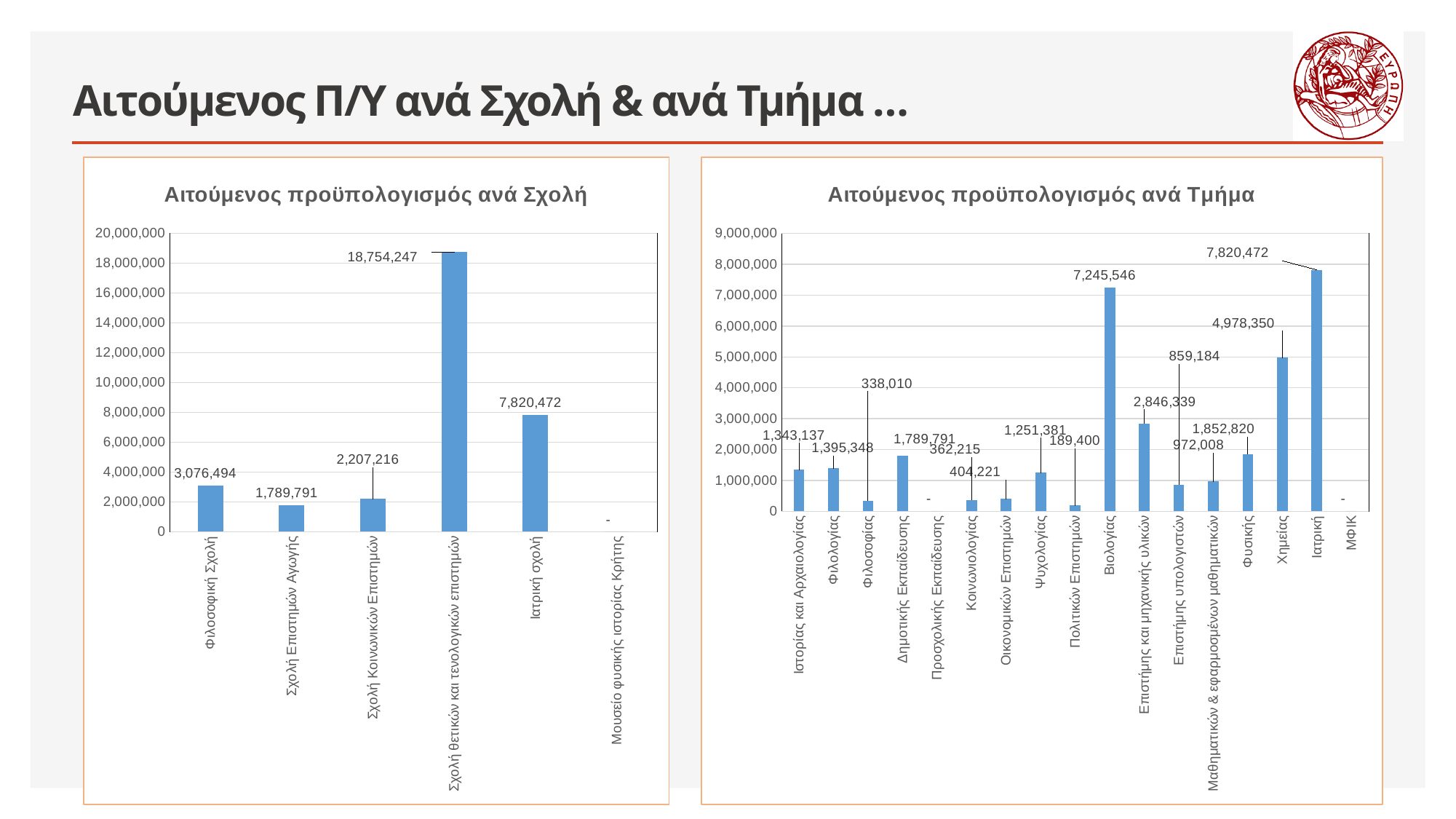
In the chart 'Αιτούμενος προϋπολογισμός ανά Τμήμα', what is the value for Βιολογίας? 7,245,546 In the chart 'Αιτούμενος προϋπολογισμός ανά Τμήμα', which is larger, Χημείας or Επιστήμης και μηχανικής υλικών? Χημείας What type of chart is 'Αιτούμενος προϋπολογισμός ανά Τμήμα'? bar chart In the chart 'Αιτούμενος προϋπολογισμός ανά Σχολή', what is the value for Ιατρική σχολή? 7,820,472 In the chart 'Αιτούμενος προϋπολογισμός ανά Τμήμα', what is the value for Πολιτικών Επιστημών? 189,400 In the chart 'Αιτούμενος προϋπολογισμός ανά Σχολή', what is the value for Σχολή θετικών και τεχνολογικών επιστημών? 18,754,247 In the chart 'Αιτούμενος προϋπολογισμός ανά Τμήμα', is the value for Φυσικής greater or less than 1,000,000? greater In the chart 'Αιτούμενος προϋπολογισμός ανά Σχολή', what is the difference between Φιλοσοφική Σχολή and Σχολή Κοινωνικών Επιστημών? 869,278 In the chart 'Αιτούμενος προϋπολογισμός ανά Σχολή', which school has the highest requested budget? Σχολή θετικών και τενολογικών επιστημών In the chart 'Αιτούμενος προϋπολογισμός ανά Σχολή', how many categories are shown on the x axis? 6 In the chart 'Αιτούμενος προϋπολογισμός ανά Τμήμα', which department has the highest requested budget? Ιατρική In the chart 'Αιτούμενος προϋπολογισμός ανά Τμήμα', what is the difference between Ιατρική and Βιολογίας? 574,926